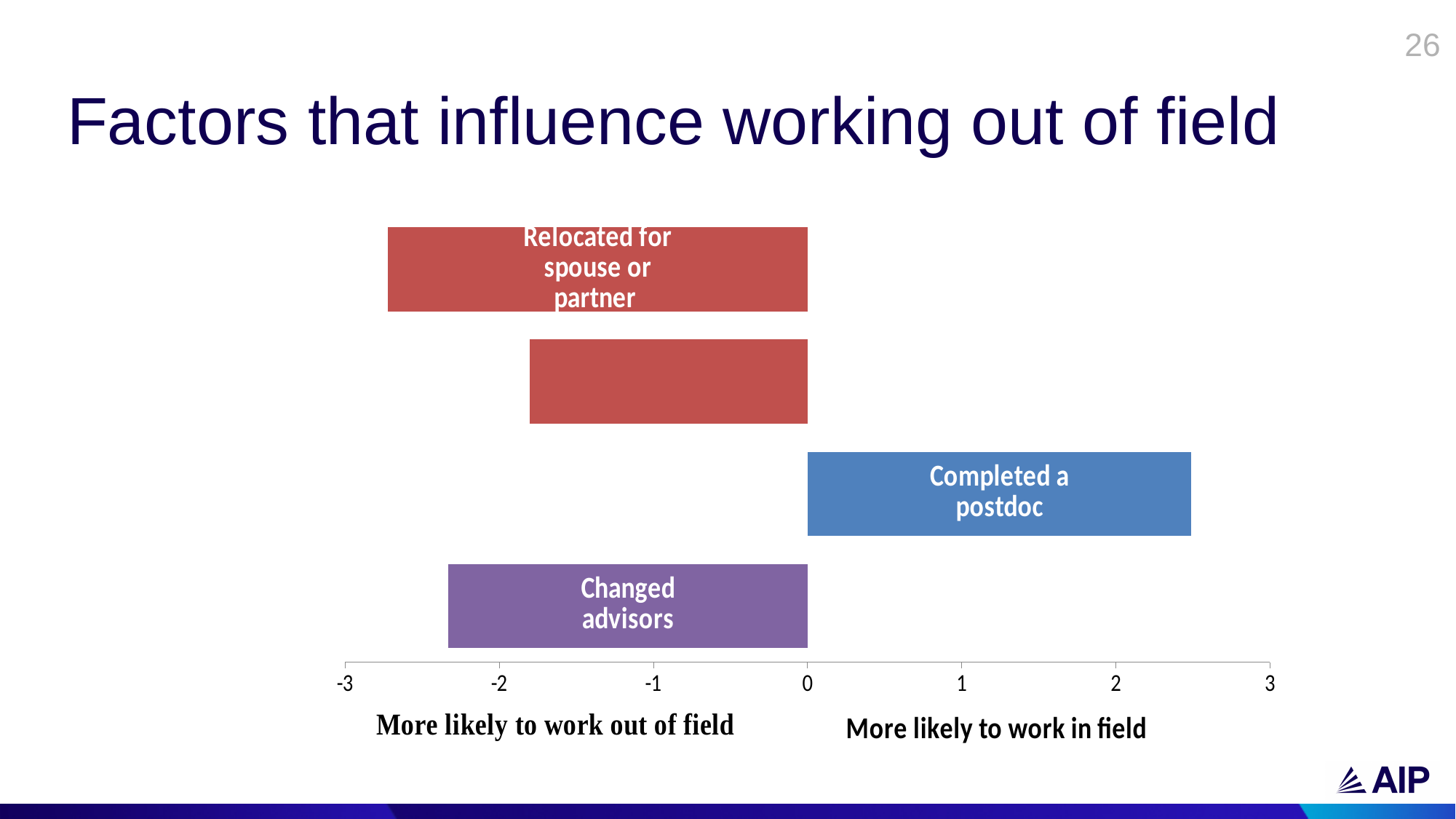
Is the value for Completed a postdoc greater or less than 2? greater Which is the only factor shown as more likely to work in field (positive side of the axis)? Completed a postdoc Which factor has the lowest (most negative) value in the chart? Relocated for spouse or partner Which bar extends further to the left: Relocated for spouse or partner or Changed advisors? Relocated for spouse or partner Is the value for Changed advisors greater or less than 0? less Is the value for Changed advisors greater or less than -2? less How many bars are plotted in the chart? 4 Which factor has the highest (most positive) value in the chart? Completed a postdoc What kind of chart is shown on the slide? Bar chart What label appears under the negative side of the x axis? More likely to work out of field What is the title of the slide? Factors that influence working out of field